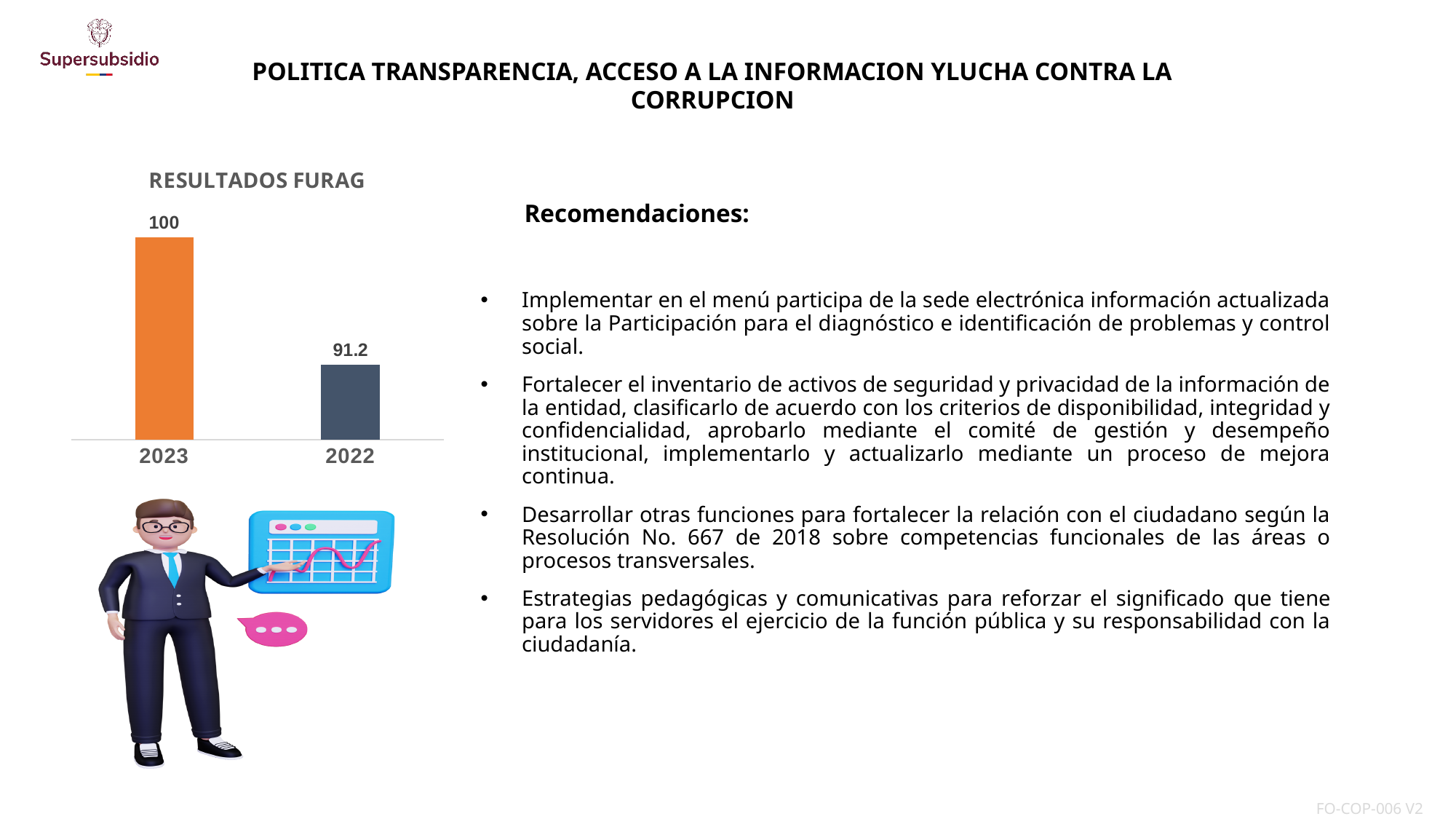
Do the values in the RESULTADOS FURAG chart rise or fall from left to right along the x axis? fall What is the value for 2023 in the RESULTADOS FURAG chart? 100 How many categories are shown in the RESULTADOS FURAG chart? 2 In the RESULTADOS FURAG chart, which is larger, the value for 2023 or the value for 2022? 2023 What colour is the bar for 2023 in the RESULTADOS FURAG chart? orange Which category has the lowest value in the RESULTADOS FURAG chart? 2022 Which category has the highest value in the RESULTADOS FURAG chart? 2023 What is the value for 2022 in the RESULTADOS FURAG chart? 91.2 What kind of chart is the RESULTADOS FURAG chart? bar chart What is the title of the chart on the slide? RESULTADOS FURAG What is the difference between the 2023 and 2022 values in the RESULTADOS FURAG chart? 8.8